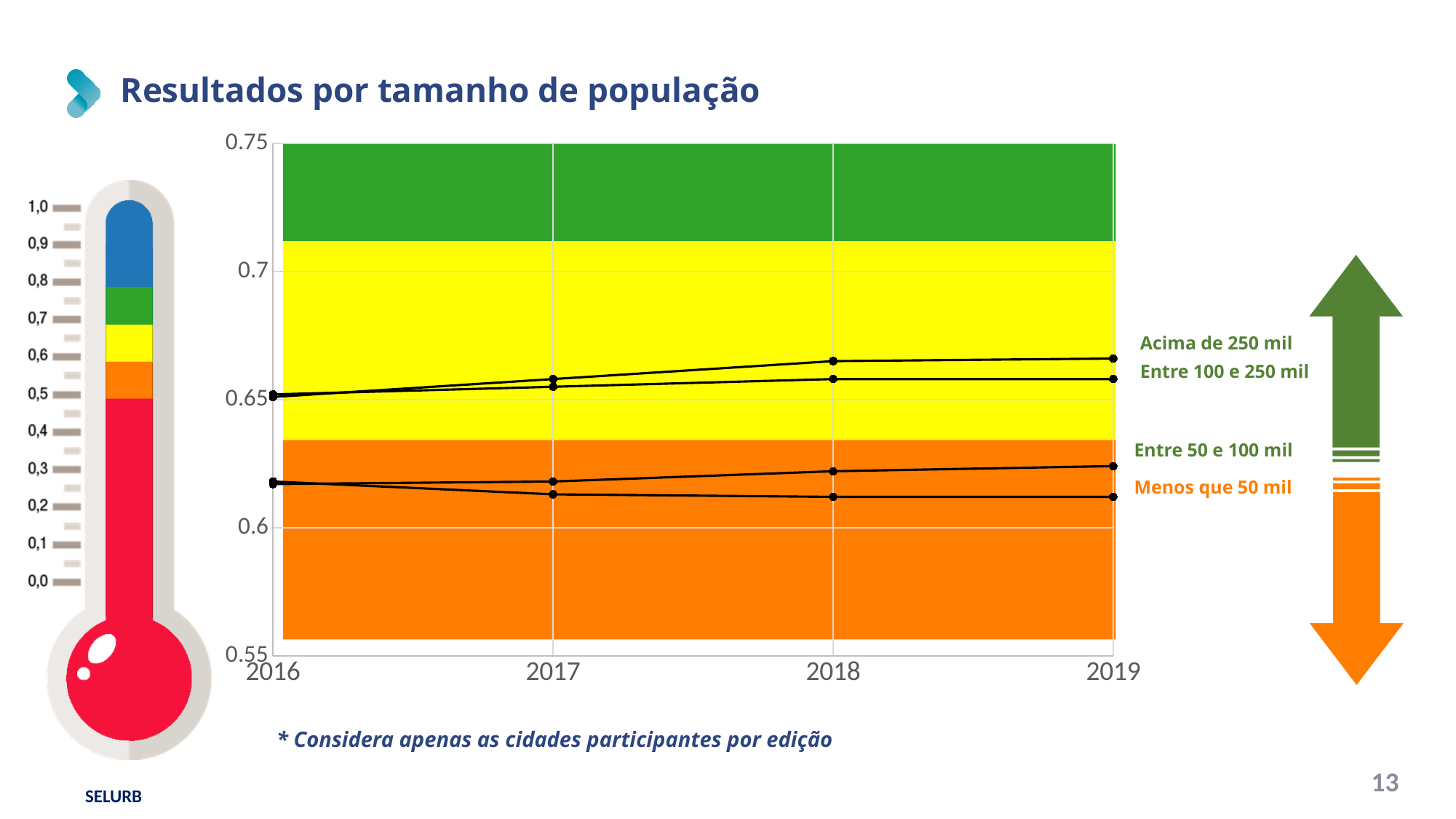
Is the value for 'Acima de 250 mil' in 2019 greater or less than 0.65? greater Is the value for 'Entre 50 e 100 mil' in 2018 greater or less than 0.6? greater What kind of chart is shown on the slide? line chart Does the value for 'Acima de 250 mil' rise or fall from 2016 to 2019? rise Which series has the highest value in 2019? Acima de 250 mil What is the title of the slide containing the chart? Resultados por tamanho de população Is the value for 'Menos que 50 mil' in 2019 greater or less than 0.65? less What is the first year shown on the x axis of the chart? 2016 Which series has the lowest value in 2019? Menos que 50 mil In 2019, which is larger: the value for 'Acima de 250 mil' or the value for 'Menos que 50 mil'? Acima de 250 mil How many population-size series are labelled on the chart? 4 How many years are plotted along the x axis of the chart? 4